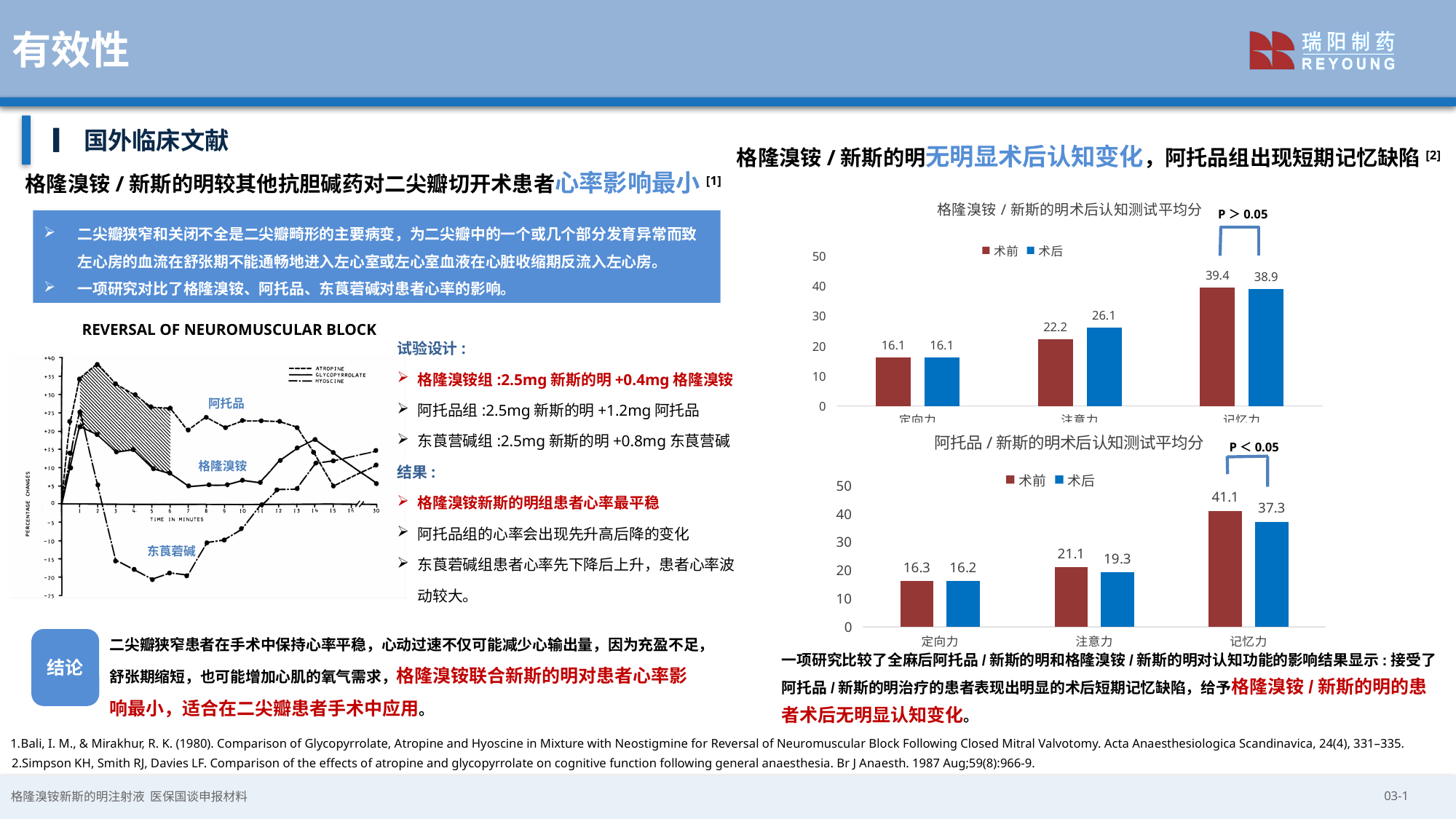
In the chart titled 格隆溴铵 / 新斯的明术后认知测试平均分, for 注意力, which is larger: the 术前 value or the 术后 value? 术后 In the chart titled 阿托品 / 新斯的明术后认知测试平均分, how many categories are shown on the x axis? 3 In the chart titled 格隆溴铵 / 新斯的明术后认知测试平均分, how many series does the legend list? 2 In the chart titled 格隆溴铵 / 新斯的明术后认知测试平均分, what is the 术后 value for 记忆力? 38.9 What kind of chart is the one titled 阿托品 / 新斯的明术后认知测试平均分? Bar chart In the chart titled 格隆溴铵 / 新斯的明术后认知测试平均分, which category has the lowest 术后 value? 定向力 In the chart titled 格隆溴铵 / 新斯的明术后认知测试平均分, what is the difference between the 术后 and 术前 values for 注意力? 3.9 In the chart titled 阿托品 / 新斯的明术后认知测试平均分, what is the difference between the 术前 and 术后 values for 记忆力? 3.8 In the chart titled 阿托品 / 新斯的明术后认知测试平均分, which category has the highest 术前 value? 记忆力 In the chart titled 阿托品 / 新斯的明术后认知测试平均分, what is the 术前 value for 记忆力? 41.1 In the chart titled 格隆溴铵 / 新斯的明术后认知测试平均分, what is the 术前 value for 注意力? 22.2 In the chart titled 阿托品 / 新斯的明术后认知测试平均分, what is the 术后 value for 注意力? 19.3